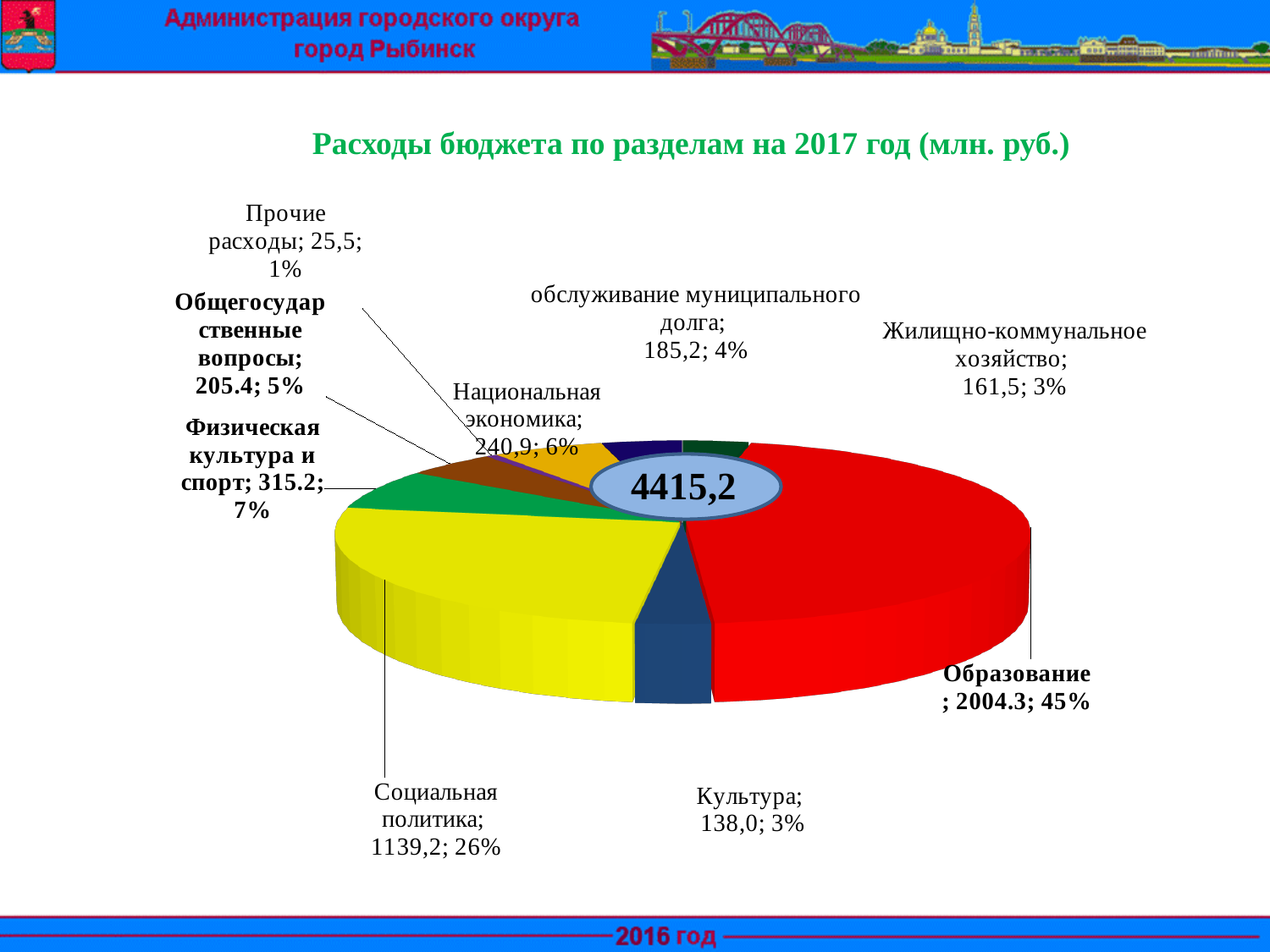
What is the title of the chart? Расходы бюджета по разделам на 2017 год (млн. руб.) What share of the pie does Физическая культура и спорт represent? 7% Which category has the smallest slice of the pie? Прочие расходы What kind of chart is shown on the slide? pie chart Which category has the largest slice of the pie? Образование What is the value shown for Социальная политика? 1139,2 What is the value shown for Образование? 2004.3 What is the value shown for Культура? 138,0 Which is larger, Общегосударственные вопросы or Жилищно-коммунальное хозяйство? Общегосударственные вопросы What share of the pie does Национальная экономика represent? 6% How many categories are shown in the pie chart? 9 What total value is printed in the centre of the pie chart? 4415,2